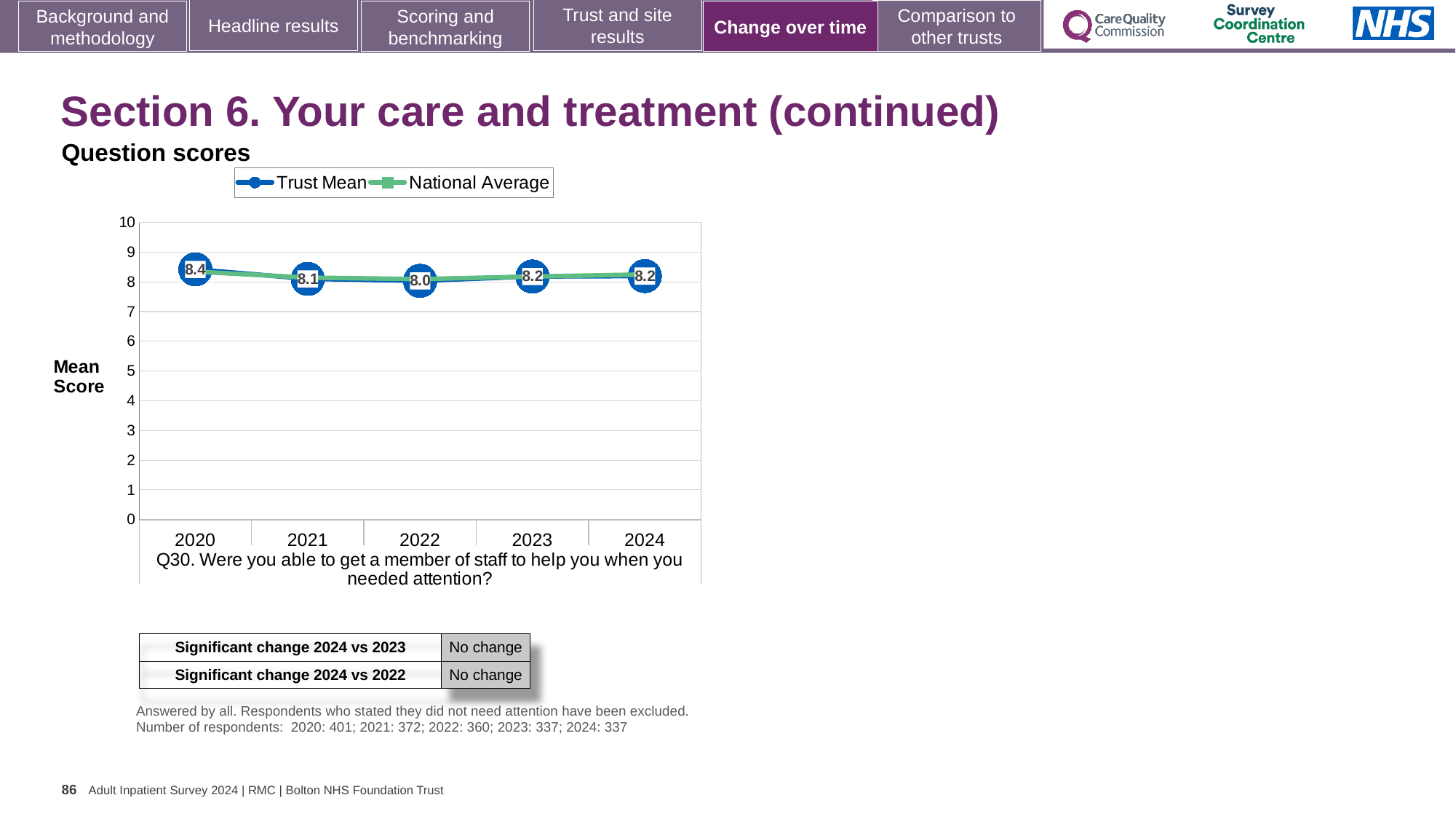
In which year is the Trust Mean score lowest? 2022 What is the label of the y axis? Mean Score In which year is the Trust Mean score highest? 2020 What is the Trust Mean score for 2024? 8.2 What is the difference between the Trust Mean score in 2020 and in 2022? 0.4 What kind of chart is shown? Line chart How many years are plotted on the x axis? 5 Is the Trust Mean score for 2021 greater or less than 7? greater Which is larger, the Trust Mean score for 2021 or for 2023? 2023 What is the Trust Mean score for 2022? 8.0 How many series does the legend list? 2 What is the Trust Mean score for 2020? 8.4